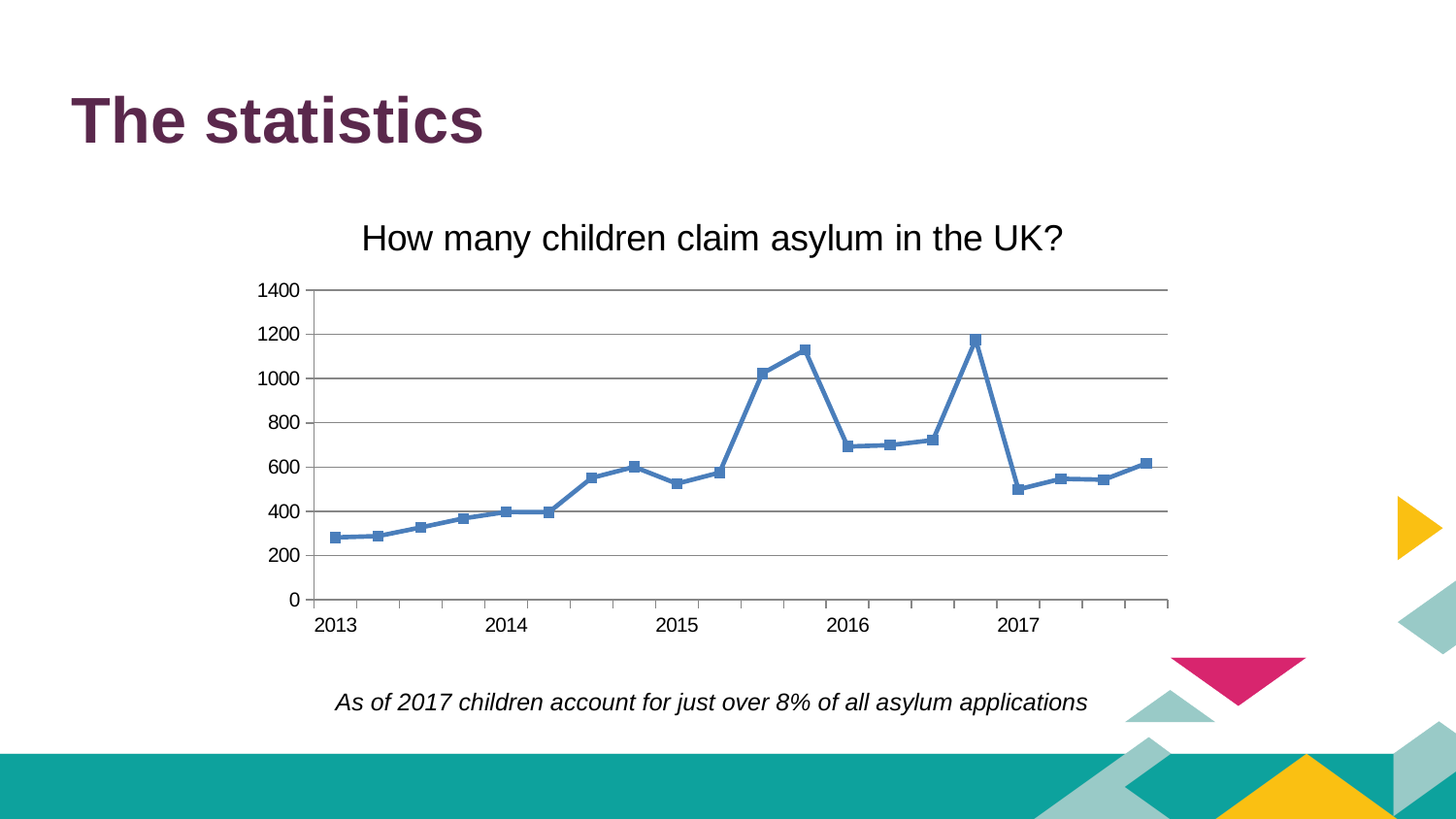
Is the value at the 2015 point greater or less than 400? greater How many years are labelled on the x axis? 5 Which is larger, the value at the 2016 point or the value at the 2017 point? 2016 Do the values rise or fall between the 2013 point and the 2014 point? rise Which is larger, the value at the 2014 point or the value at the 2015 point? 2015 What kind of chart is shown on the slide? line chart How many data points are plotted on the line? 20 Is the value at the 2013 point greater or less than 400? less What is the highest value shown on the y axis? 1400 Is the value at the 2016 point greater or less than 600? greater What is the title of the chart? How many children claim asylum in the UK?